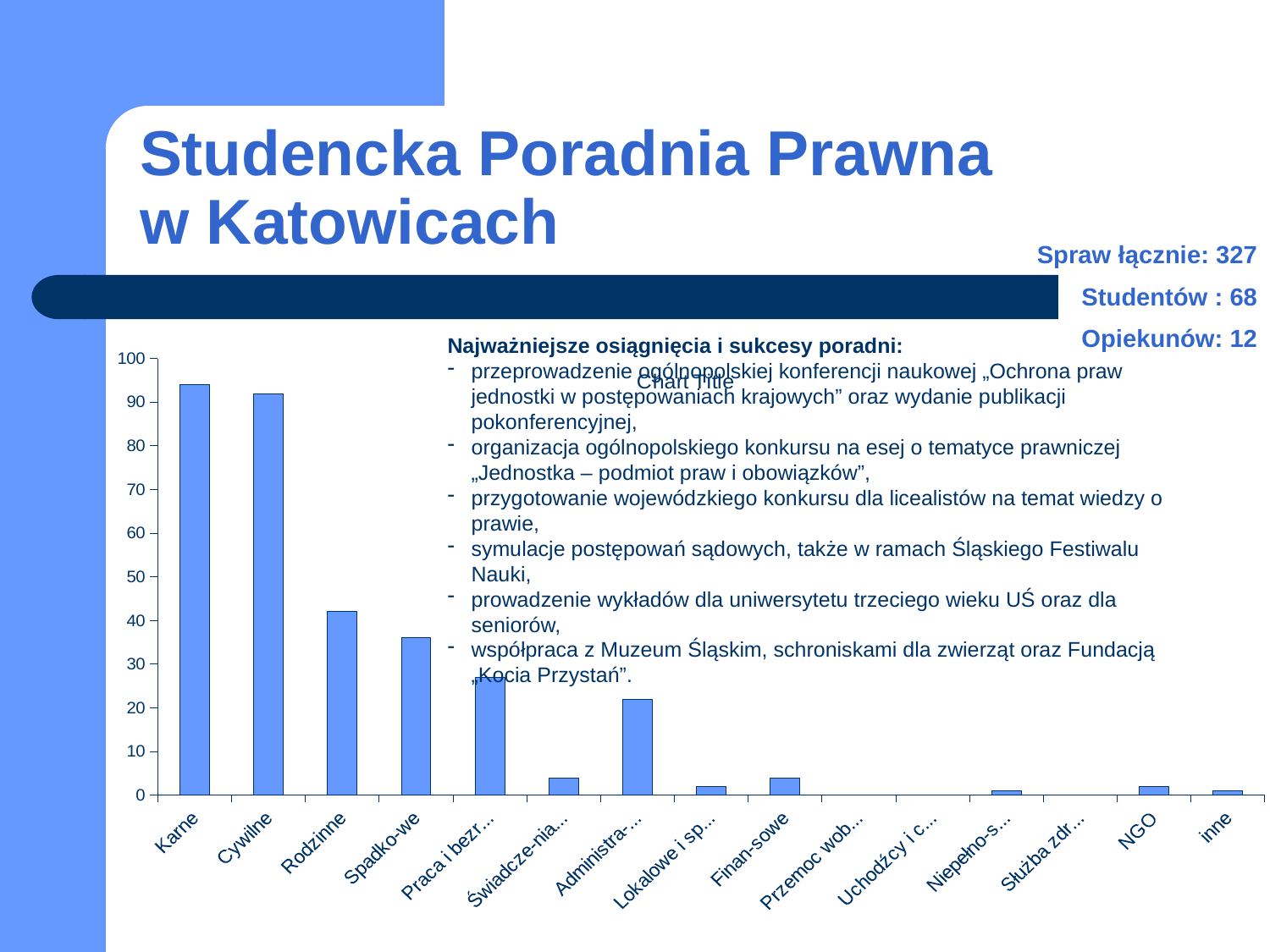
How many categories are shown on the x axis of the chart? 15 Is the value for Rodzinne greater or less than 40? greater Is the value for Cywilne greater or less than 80? greater Is the value for Administra-... greater or less than 30? less Do the bar values generally rise or fall from left to right along the x axis? fall What is the highest value shown on the chart's vertical axis? 100 What kind of chart is shown on the slide? bar chart Which has the larger value, Rodzinne or Spadko-we? Rodzinne Which has the larger value, Cywilne or Rodzinne? Cywilne